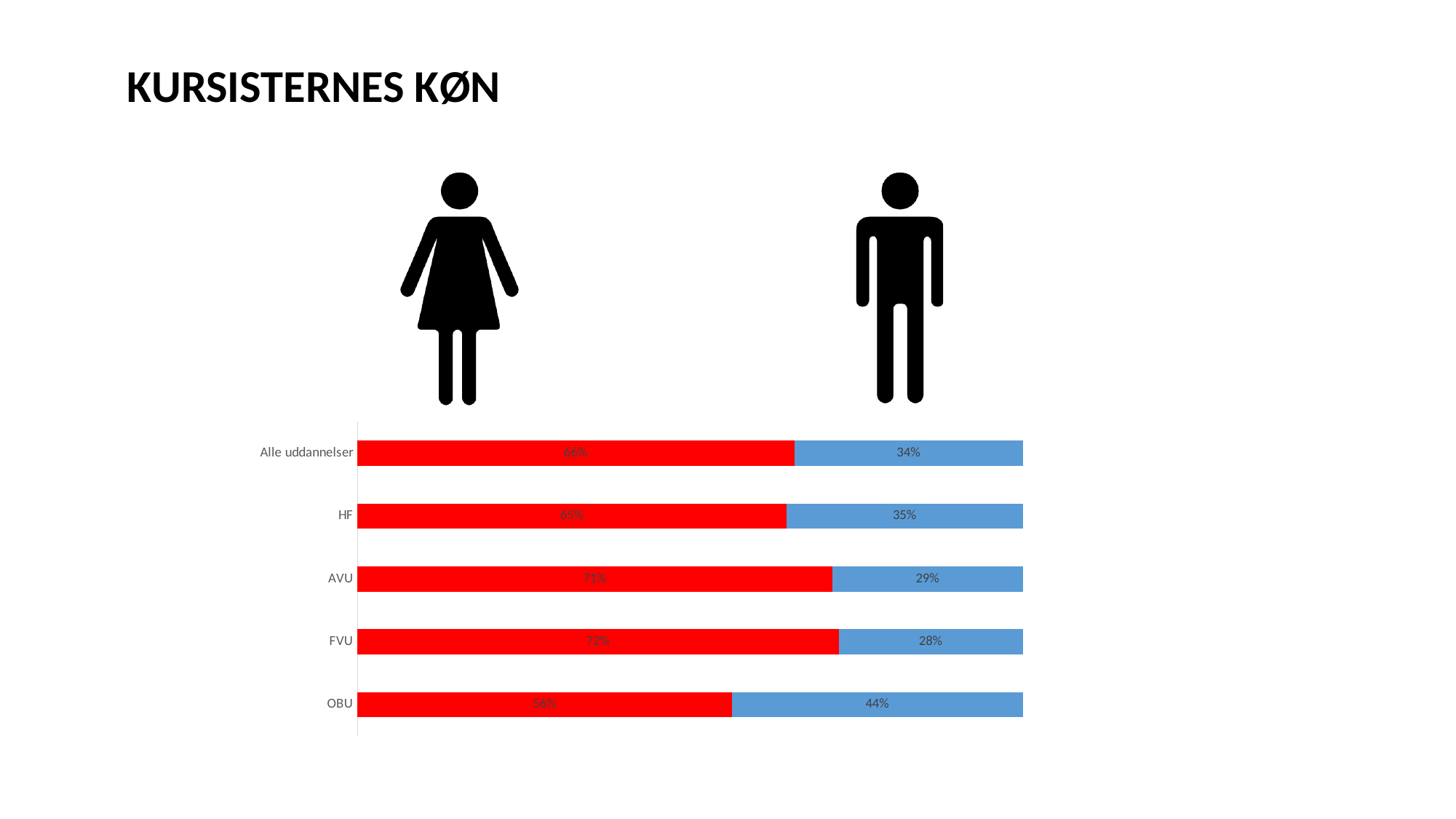
What is the value of the red segment for AVU? 71% How many categories are shown on the chart? 5 What is the difference between the red and blue segment values for FVU? 44% What is the value of the red segment for Alle uddannelser? 66% Which category has the lowest red segment value? OBU Is the red segment value larger for AVU or for HF? AVU What is the value of the blue segment for HF? 35% What kind of chart is shown on the slide? Stacked bar chart What is the total of the red and blue segments for OBU? 100% What is the value of the blue segment for OBU? 44% Which category has the highest blue segment value? OBU Which category has the highest red segment value? FVU